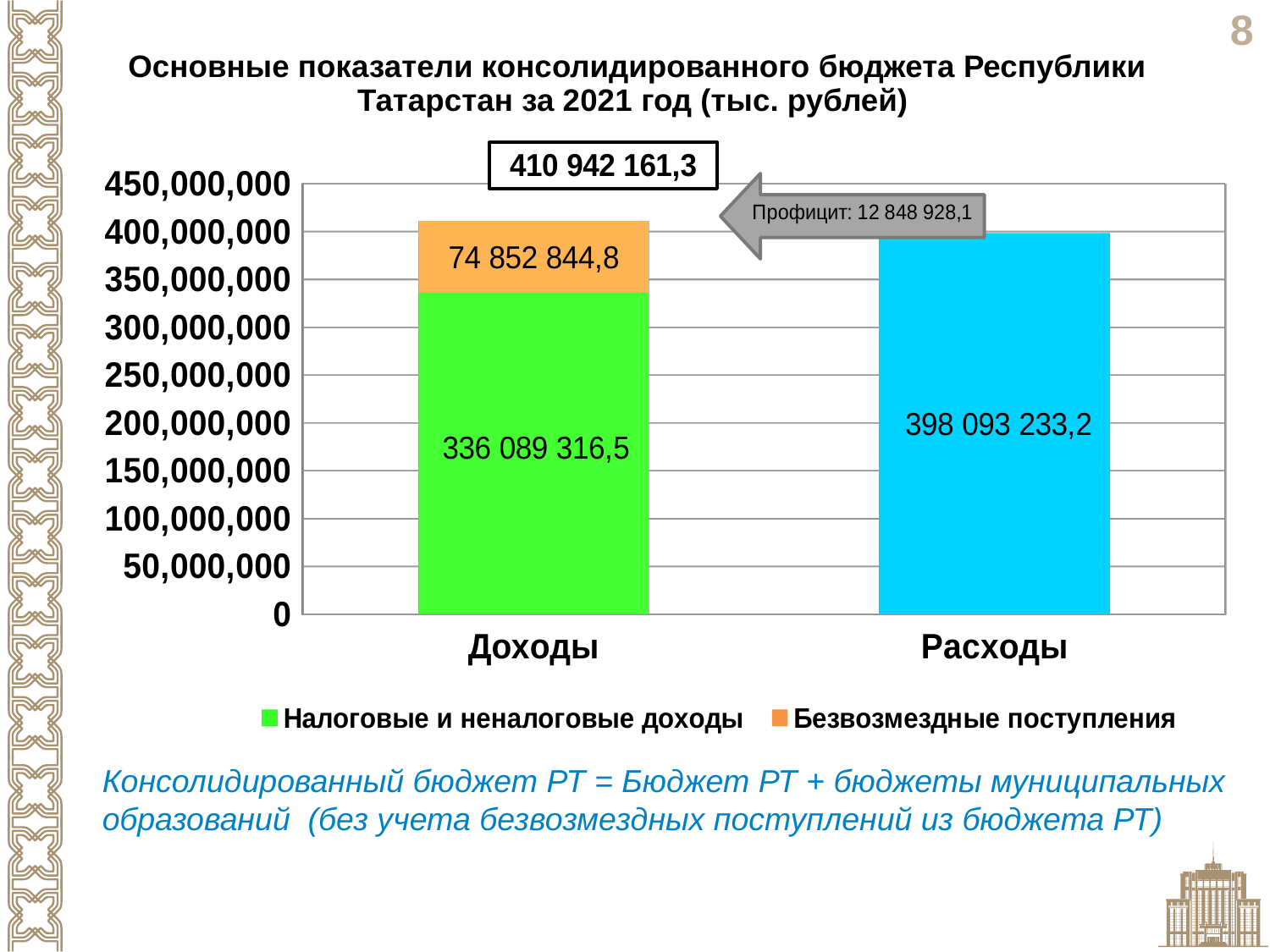
What is the value shown for 'Расходы'? 398 093 233,2 How many categories are shown on the x axis of the chart? 2 What is the value of the 'Безвозмездные поступления' segment in the 'Доходы' bar? 74 852 844,8 What is the difference between the total 'Доходы' (410 942 161,3) and 'Расходы' (398 093 233,2)? 12 848 928,1 What is the total of the stacked 'Доходы' bar? 410 942 161,3 Is the 'Безвозмездные поступления' segment greater or less than 100,000,000? less Which segment of the 'Доходы' bar is larger: 'Налоговые и неналоговые доходы' or 'Безвозмездные поступления'? Налоговые и неналоговые доходы What is the value of the 'Налоговые и неналоговые доходы' segment in the 'Доходы' bar? 336 089 316,5 Is the value for 'Расходы' greater or less than 350,000,000? greater How many series does the legend list? 2 Which is larger: the total 'Доходы' bar or the 'Расходы' bar? Доходы What type of chart is shown on the slide? Stacked bar chart